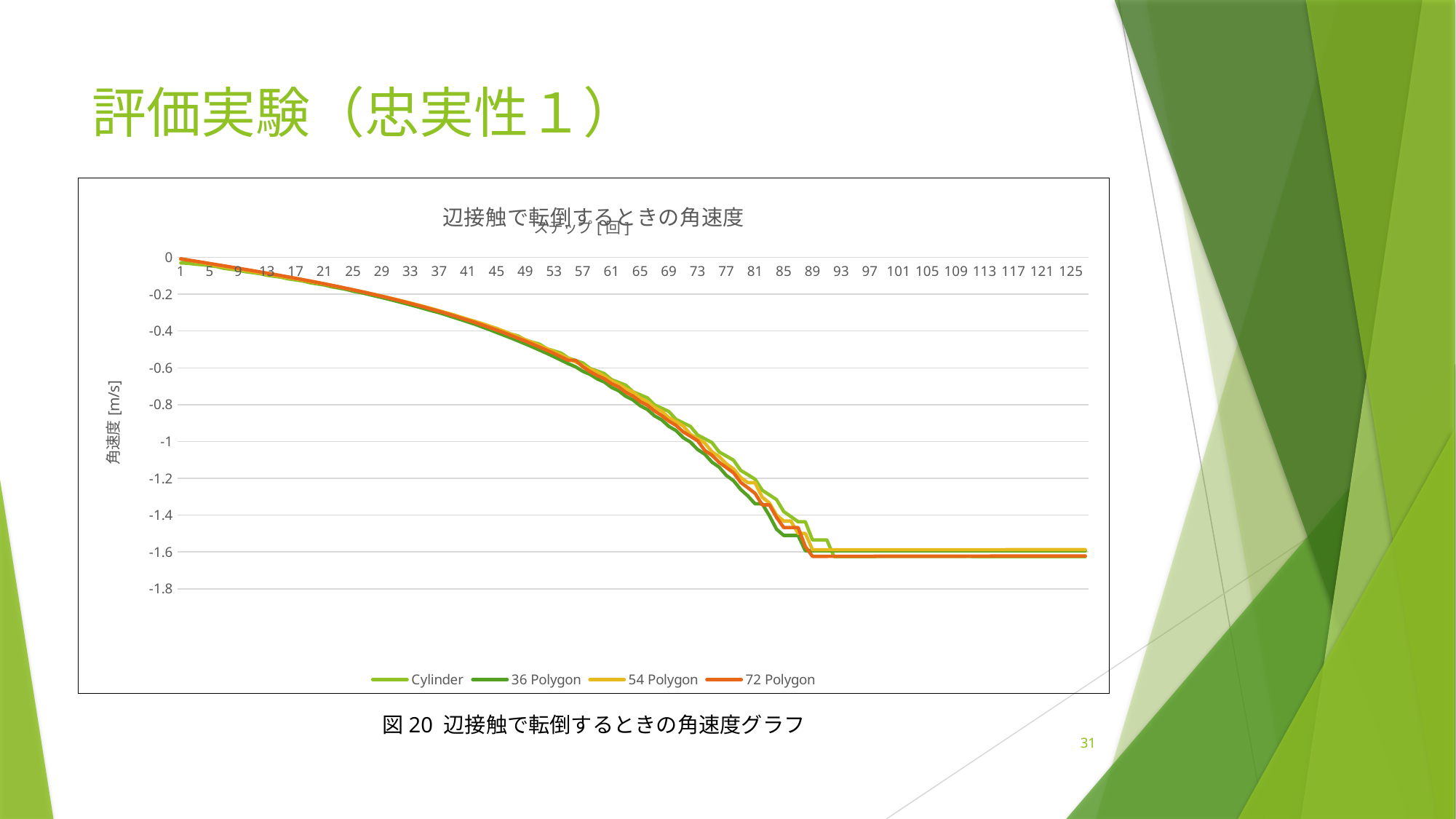
What kind of chart is shown on the slide? line chart How many series does the legend list? 4 Is the value for 54 Polygon at step 45 greater or less than -0.8? greater What are the four series named in the legend? Cylinder, 36 Polygon, 54 Polygon, 72 Polygon Do the values rise or fall along the x axis from step 1 to step 89? fall Is the value for 72 Polygon at step 105 greater or less than -1.4? less What is the lowest value shown on the y axis? -1.8 Is the value for Cylinder at step 21 greater or less than -0.2? greater How many tick labels are shown on the x axis? 32 What is the title of the chart? 辺接触で転倒するときの角速度